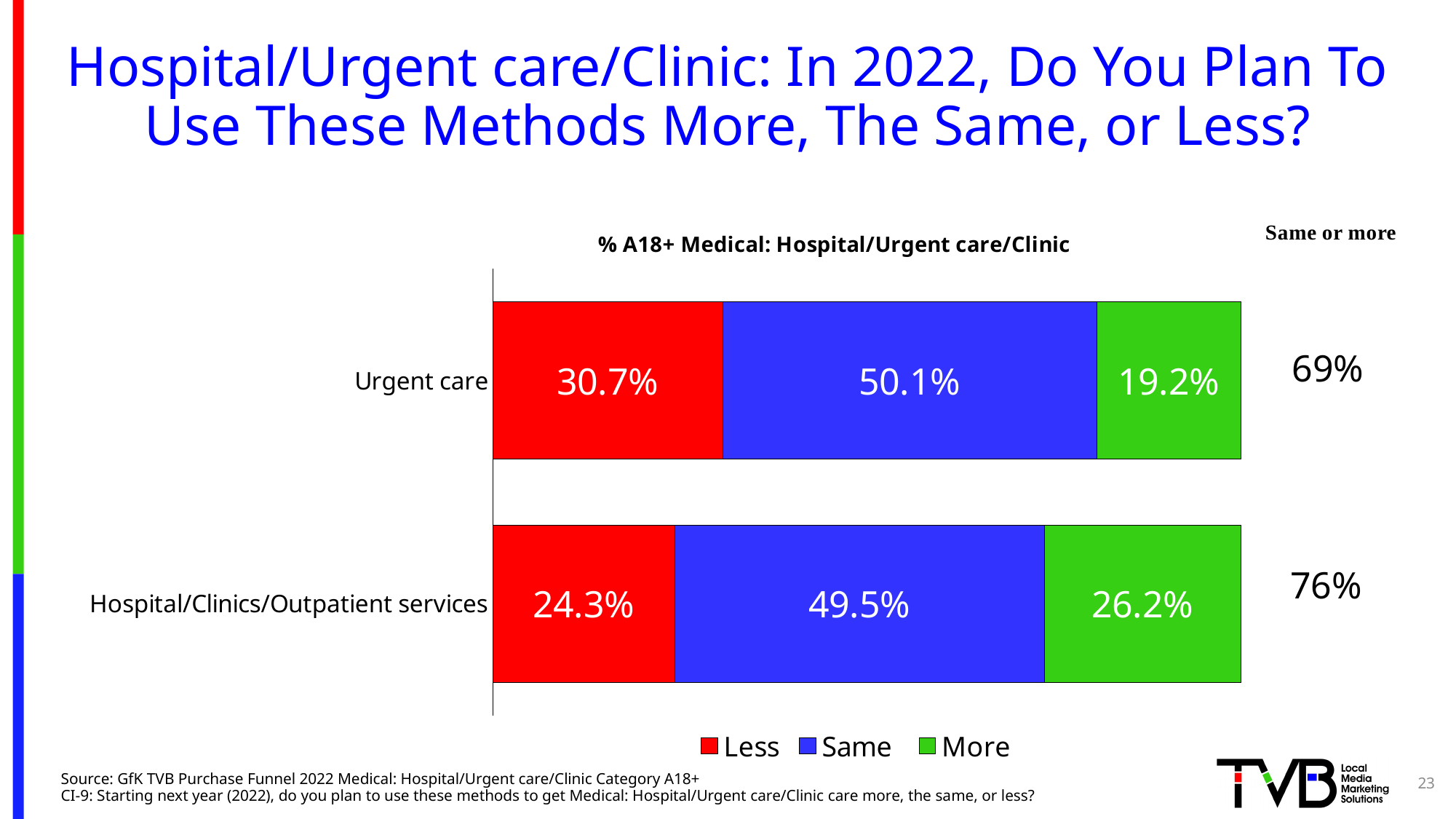
How many series does the legend list? 3 What is the 'Same or more' figure shown for Hospital/Clinics/Outpatient services? 76% What percentage of A18+ plan to use Hospital/Clinics/Outpatient services more in 2022? 26.2% What kind of chart is shown on the slide? Stacked bar chart What is the difference between the 'Less' values for Urgent care and Hospital/Clinics/Outpatient services? 6.4% Which category has the higher 'Less' value, Urgent care or Hospital/Clinics/Outpatient services? Urgent care What is the 'Same' value for Hospital/Clinics/Outpatient services? 49.5% What is the difference between the 'More' values for Hospital/Clinics/Outpatient services and Urgent care? 7.0% What percentage of A18+ plan to use Urgent care less in 2022? 30.7% How many categories are shown on the chart? 2 What is the 'More' value for Urgent care? 19.2% What colour represents the 'Same' series in the chart? Blue